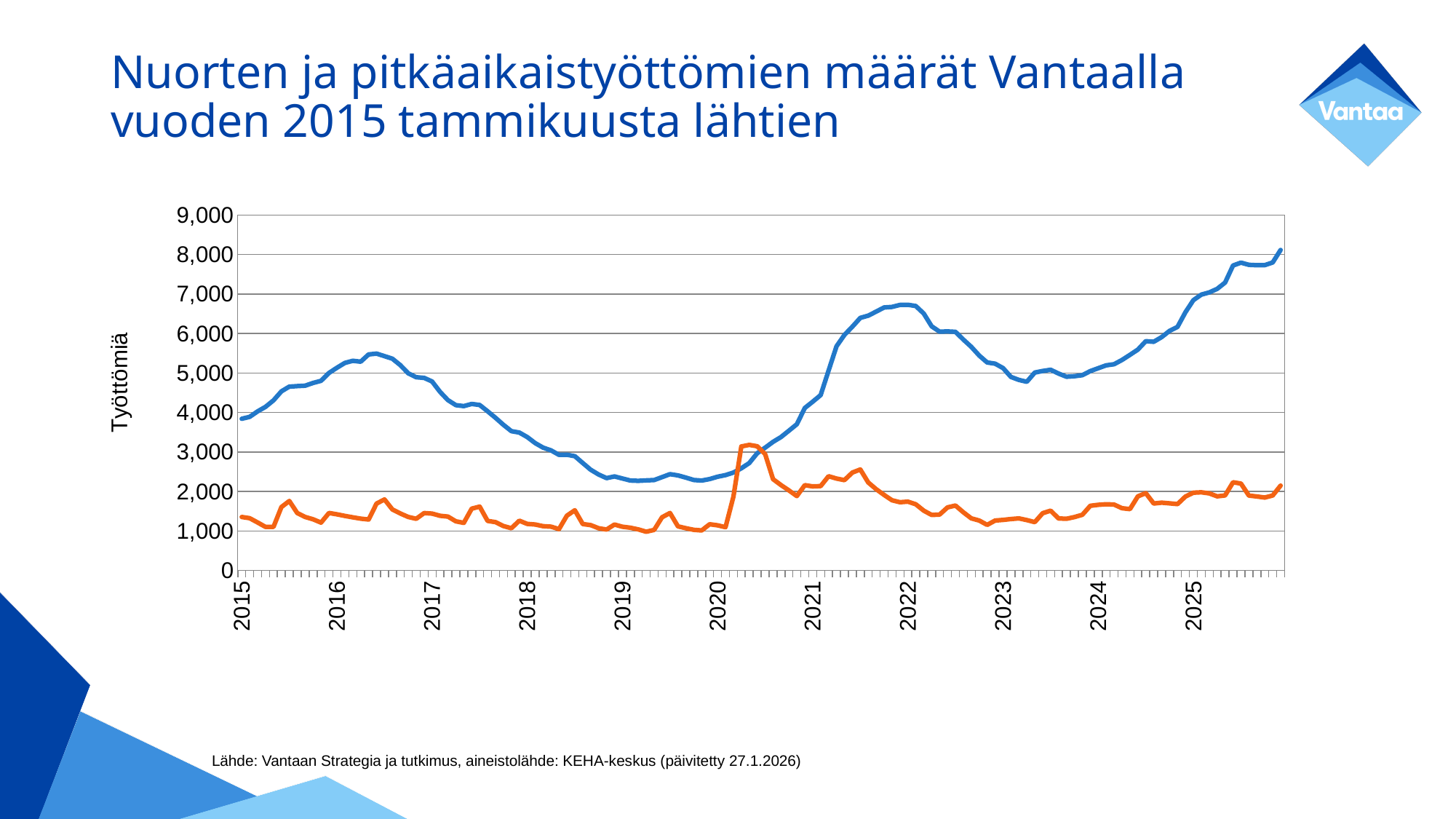
Is the peak of the blue line around the start of 2022 greater or less than 6,000? greater Is the value of the blue line at the start of 2019 greater or less than 3,000? less Is the value of the blue line at the end of 2025 greater or less than 7,000? greater How many lines are plotted on the chart? 2 What kind of chart is shown on the slide? line chart What is the label on the vertical axis? Työttömiä How many year labels are shown on the x axis? 11 At the start of 2019, which line has the higher value, the blue line or the orange line? the blue line Does the blue line rise or fall between the start of 2023 and the end of 2025? rise What is the highest value shown on the vertical axis? 9,000